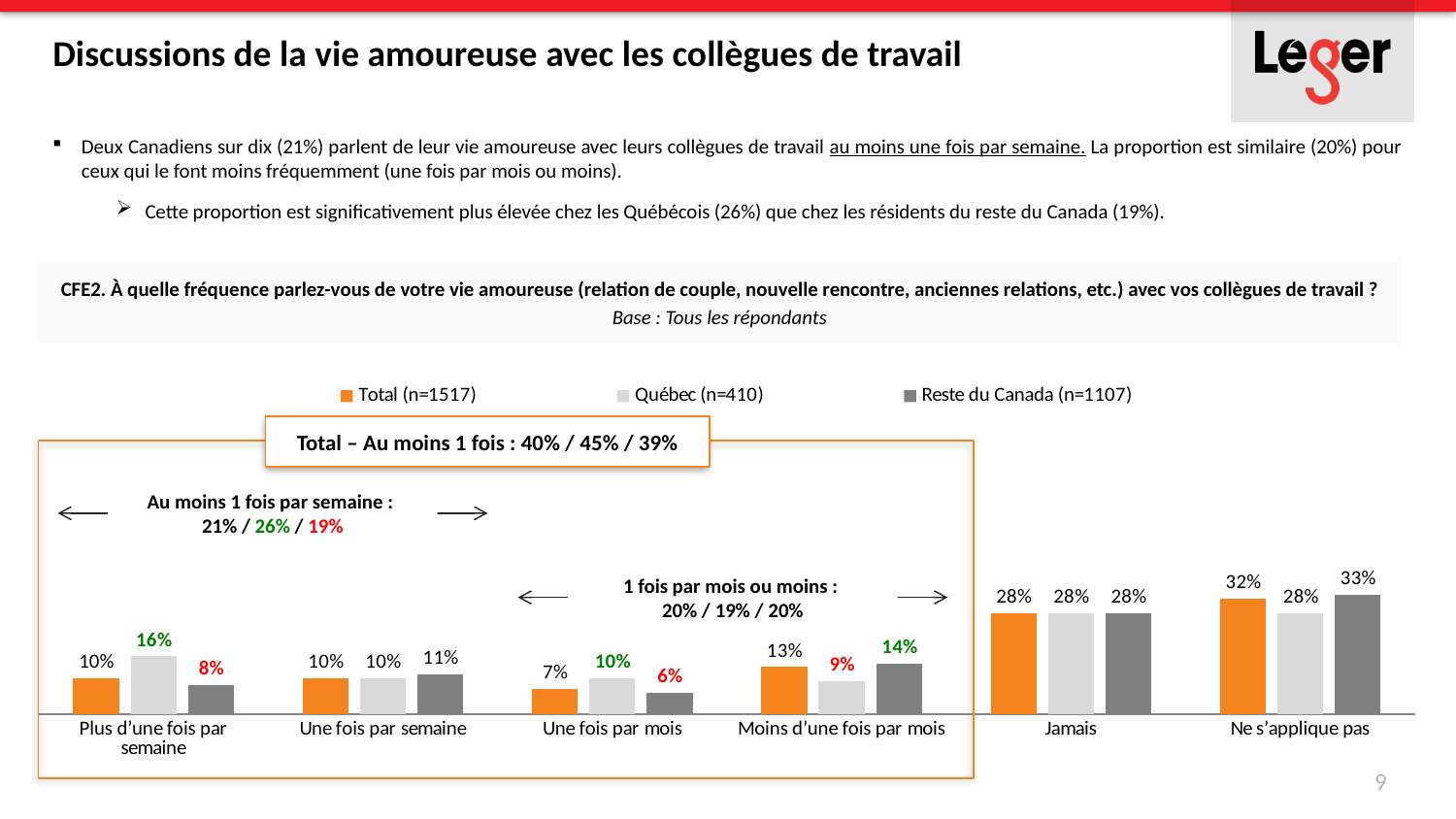
What is the Québec (n=410) value for "Plus d'une fois par semaine"? 16% What is the difference between the Québec (n=410) and Reste du Canada (n=1107) values for "Plus d'une fois par semaine"? 8% What kind of chart is shown on the slide? Bar chart Which category has the highest Total (n=1517) value? Ne s'applique pas For "Moins d'une fois par mois", which is larger: the Québec (n=410) value or the Reste du Canada (n=1107) value? Reste du Canada (n=1107) What is the Reste du Canada (n=1107) value for "Ne s'applique pas"? 33% What is the Total (n=1517) value for "Jamais"? 28% What is the difference between the Total (n=1517) values for "Ne s'applique pas" and "Jamais"? 4% How many series does the chart legend list? 3 How many categories are shown on the x axis of the chart? 6 What is the Total (n=1517) value for "Une fois par mois"? 7% Which category has the lowest Reste du Canada (n=1107) value? Une fois par mois